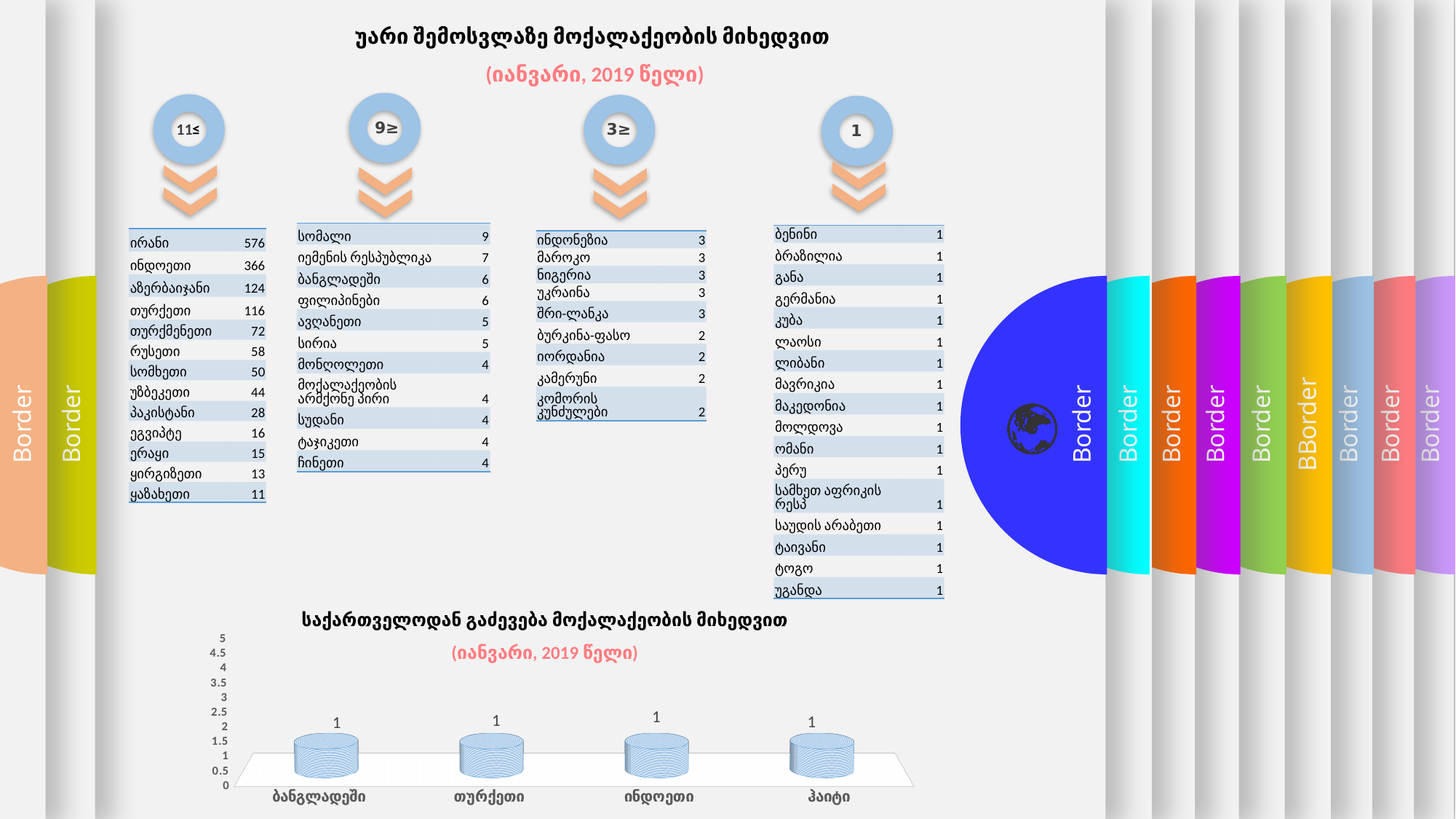
In the bar chart at the bottom of the slide, what is the difference between the values for ბანგლადეში and ინდოეთი? 0 In the bar chart at the bottom of the slide, what is the value for ინდოეთი? 1 What is the highest value shown on the vertical axis of the bar chart at the bottom of the slide? 5 In the bar chart at the bottom of the slide, is the value for ჰაიტი greater or less than 2? less In the bar chart at the bottom of the slide, what is the value for თურქეთი? 1 What period is given in the subtitle of the bar chart at the bottom of the slide? იანვარი, 2019 წელი How many categories are plotted in the bar chart at the bottom of the slide? 4 In the bar chart at the bottom of the slide, what is the value for ბანგლადეში? 1 In the bar chart at the bottom of the slide, what is the value for ჰაიტი? 1 In the bar chart at the bottom of the slide, do the values rise, fall, or stay the same from left to right? stay the same What kind of chart is shown at the bottom of the slide? bar chart